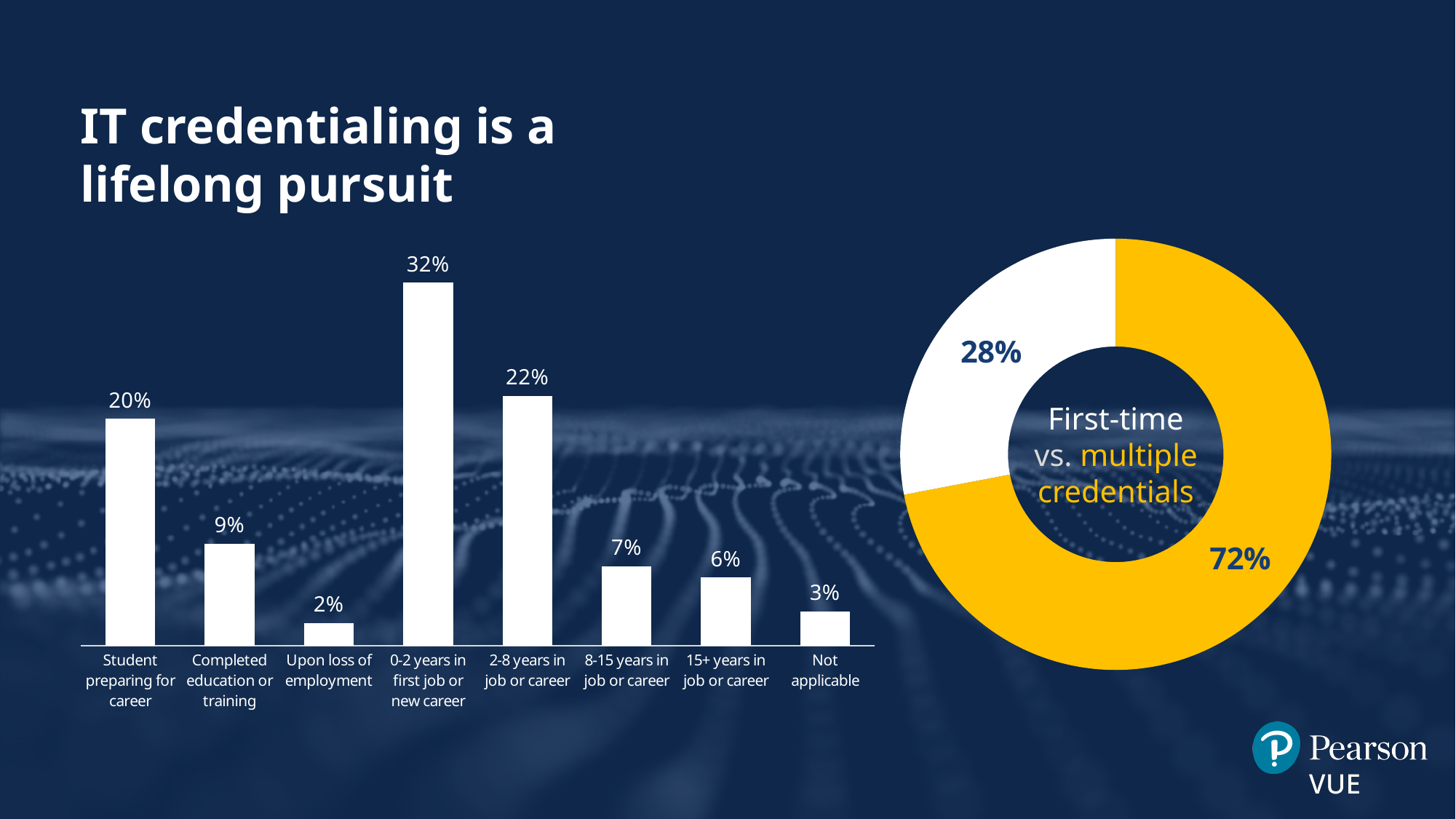
In the donut chart on the right, what share is shown for multiple credentials? 72% In the donut chart on the right, what share is shown for first-time credentials? 28% In the bar chart on the left, which category has the highest value? 0-2 years in first job or new career What kind of chart is on the left side of the slide? Bar chart In the bar chart on the left, what is the value for '0-2 years in first job or new career'? 32% In the bar chart on the left, which is larger: 'Completed education or training' or '8-15 years in job or career'? Completed education or training What colour is the 'multiple credentials' segment in the donut chart on the right? Yellow In the bar chart on the left, what is the value for '15+ years in job or career'? 6% How many categories are shown in the bar chart on the left? 8 In the bar chart on the left, what is the value for 'Student preparing for career'? 20% In the bar chart on the left, which category has the lowest value? Upon loss of employment In the bar chart on the left, what is the difference between '0-2 years in first job or new career' and '2-8 years in job or career'? 10%